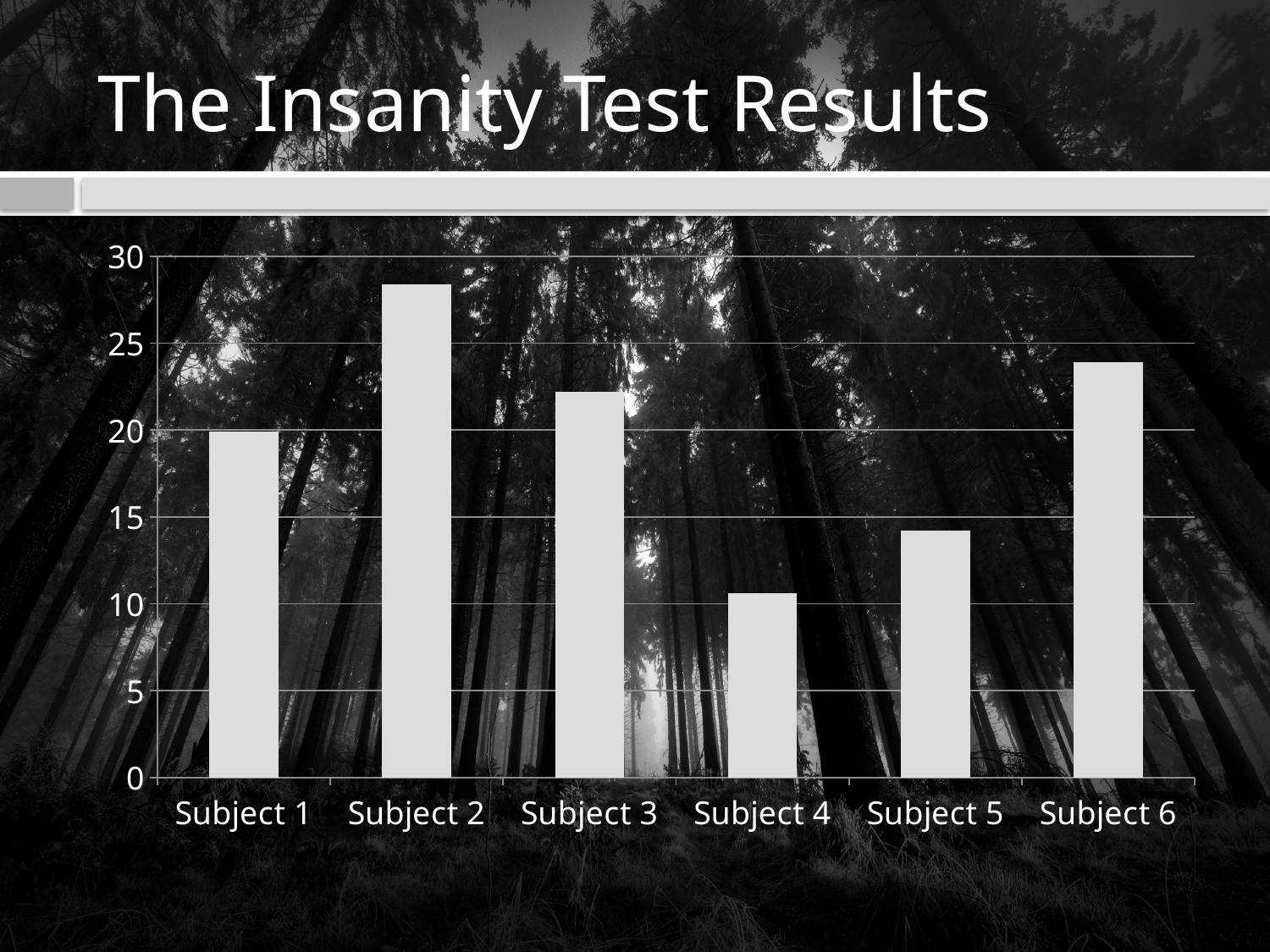
Is the value for Subject 6 greater or less than 25? less Is the value for Subject 4 greater or less than 15? less What kind of chart is shown on the slide? bar chart Which is larger, the value for Subject 1 or the value for Subject 5? Subject 1 Is the value for Subject 3 greater or less than 20? greater Which is larger, the value for Subject 6 or the value for Subject 2? Subject 2 Which subject has the lowest value? Subject 4 What is the title of the slide containing the chart? The Insanity Test Results Which subject has the highest value? Subject 2 How many subjects are plotted on the chart? 6